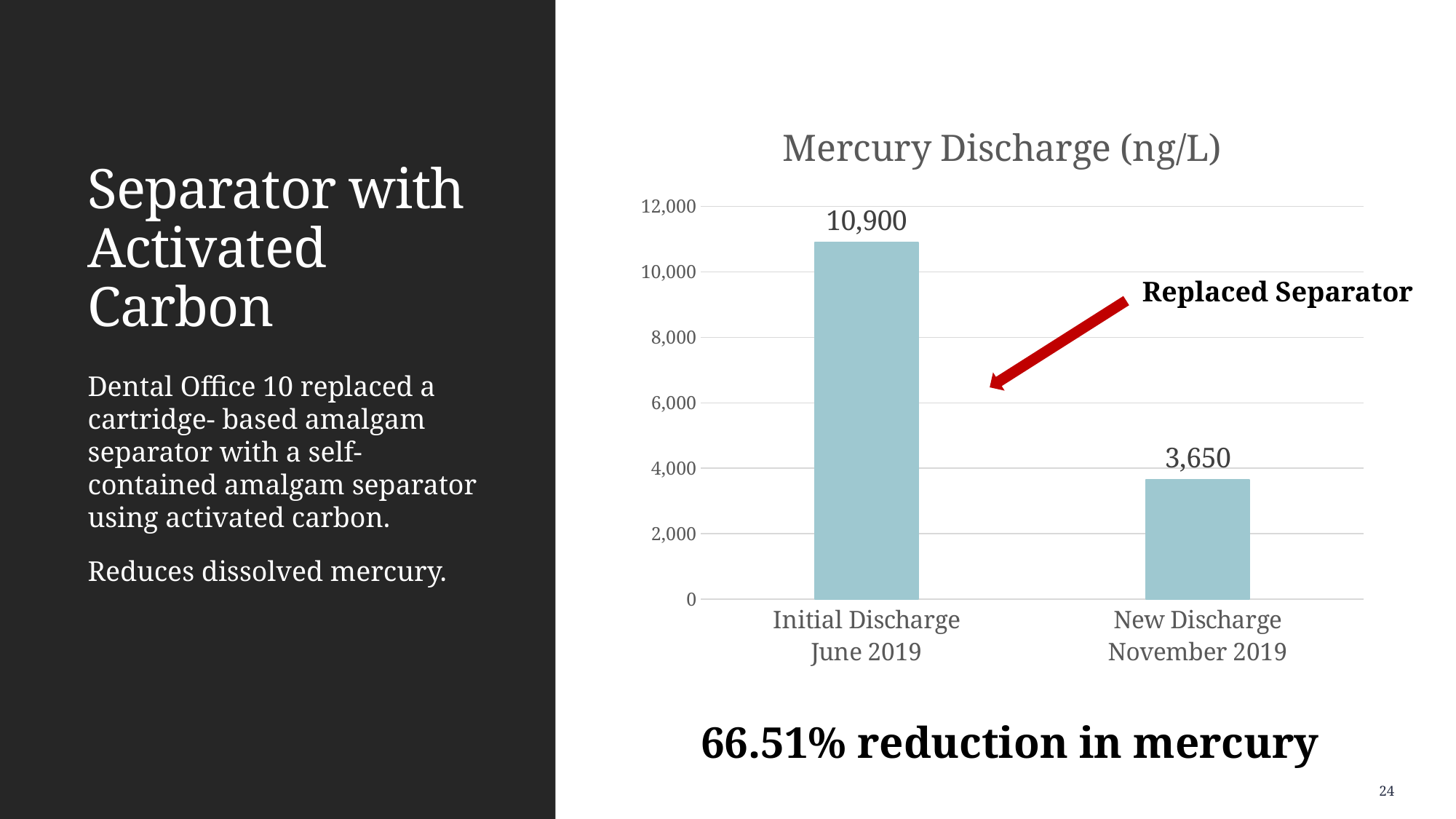
Do the values rise or fall from Initial Discharge June 2019 to New Discharge November 2019? Fall What is the mercury discharge value for Initial Discharge June 2019? 10,900 What is the mercury discharge value for New Discharge November 2019? 3,650 What is the title of the chart? Mercury Discharge (ng/L) Which category has the lowest mercury discharge? New Discharge November 2019 How many categories are shown in the chart? 2 Which category has the highest mercury discharge? Initial Discharge June 2019 What is the difference in mercury discharge between Initial Discharge June 2019 and New Discharge November 2019? 7,250 Is the value for Initial Discharge June 2019 greater or less than 10,000? greater What kind of chart is shown on the slide? Bar chart Which is larger, the mercury discharge for Initial Discharge June 2019 or for New Discharge November 2019? Initial Discharge June 2019 Is the value for New Discharge November 2019 greater or less than 4,000? less